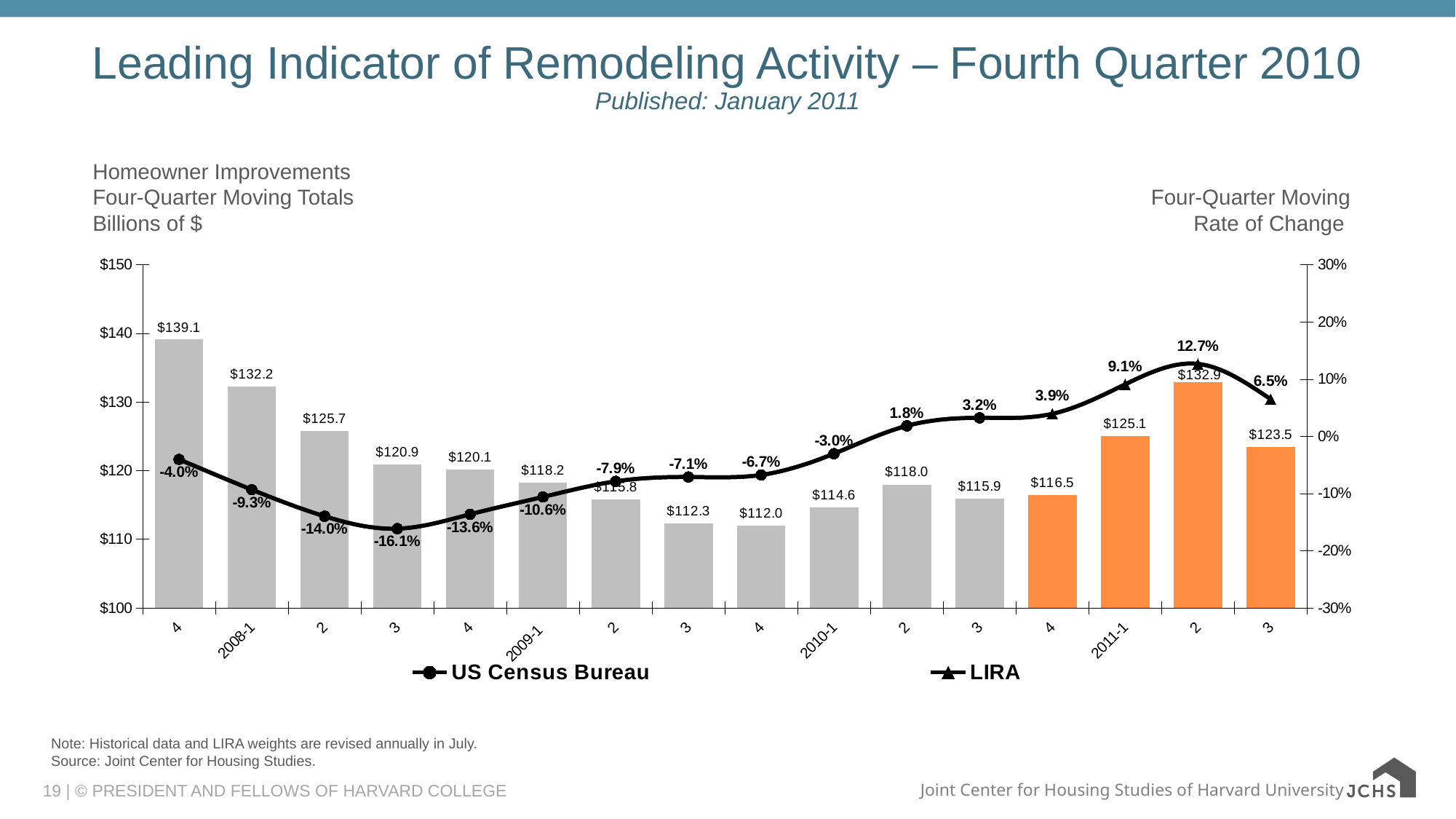
What is the four-quarter moving total for 2008-1? $132.2 Which quarter has the highest four-quarter moving rate of change on the line? 2011 quarter 2 (12.7%) What is the difference between the four-quarter moving totals for 2011 quarter 2 and 2011-1? $7.8 Which quarter has the lowest four-quarter moving total bar? 2009 quarter 4 ($112.0) What is the lowest rate of change value labeled on the line? -16.1% How many series does the legend list? 2 Do the four-quarter moving total bars rise or fall from the first bar through 2009 quarter 4? Fall How many bars are plotted in the chart? 16 What is the four-quarter moving rate of change shown for 2010-1? -3.0% Which is larger, the four-quarter moving total for 2010 quarter 2 or 2010 quarter 3? 2010 quarter 2 ($118.0) What kind of chart is this? Combination bar and line chart What is the four-quarter moving total for the last bar (2011 quarter 3)? $123.5